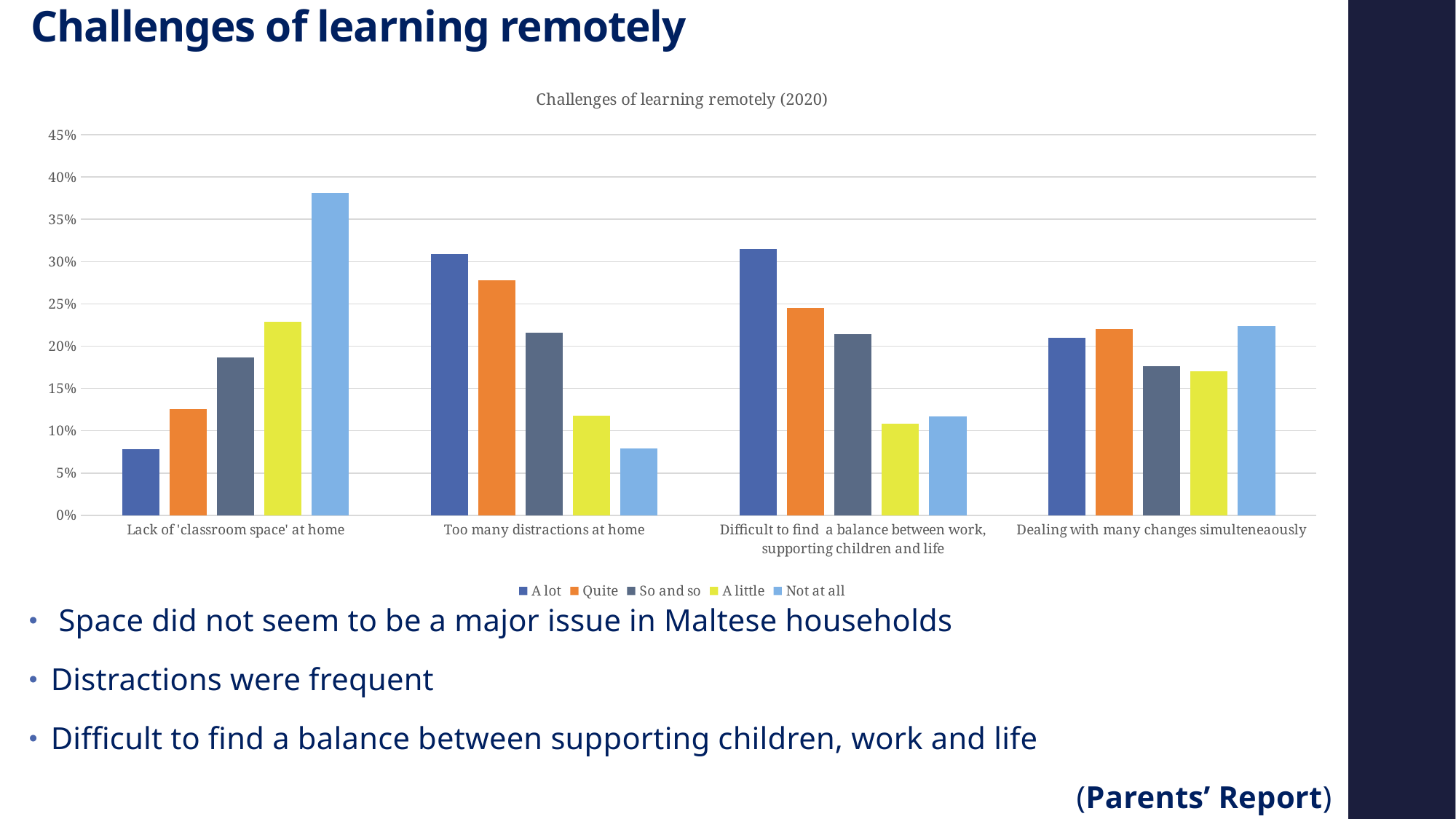
What is the title of the chart? Challenges of learning remotely (2020) How many series does the legend list? 5 Which category has the highest 'Not at all' value? Lack of 'classroom space' at home Is the 'Quite' value for Lack of 'classroom space' at home greater or less than 15%? less Is the 'A little' value for Difficult to find a balance between work, supporting children and life greater or less than 15%? less Which category has the lowest 'A lot' value? Lack of 'classroom space' at home For Too many distractions at home, which is larger: 'A lot' or 'Not at all'? A lot Is the 'A lot' value for Too many distractions at home greater or less than 25%? greater What type of chart is shown on the slide? Bar chart For Lack of 'classroom space' at home, which is larger: 'A lot' or 'Not at all'? Not at all How many challenge categories are shown on the x axis? 4